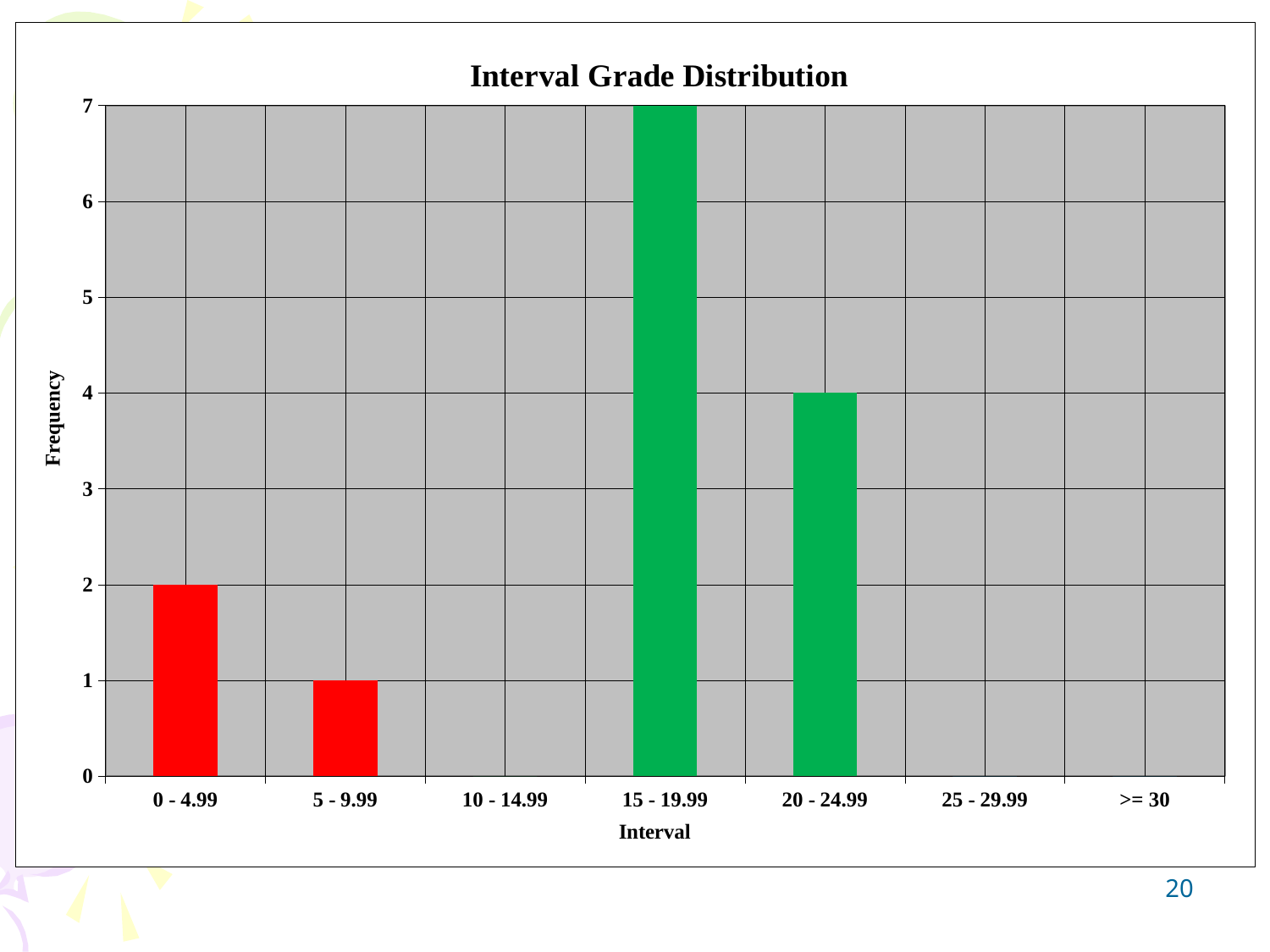
What colour are the bars for the 0 - 4.99 and 5 - 9.99 intervals? Red What is the frequency for the 15 - 19.99 interval? 7 Which has a higher frequency, the 0 - 4.99 interval or the 5 - 9.99 interval? 0 - 4.99 Is the frequency for the 20 - 24.99 interval greater or less than 3? greater What type of chart is shown on the slide? Bar chart Which interval has the highest frequency? 15 - 19.99 What is the difference in frequency between the 15 - 19.99 and 20 - 24.99 intervals? 3 What is the frequency for the 5 - 9.99 interval? 1 How many intervals are shown on the x axis? 7 What is the title of the chart? Interval Grade Distribution What is the frequency for the 0 - 4.99 interval? 2 What is the frequency for the 20 - 24.99 interval? 4